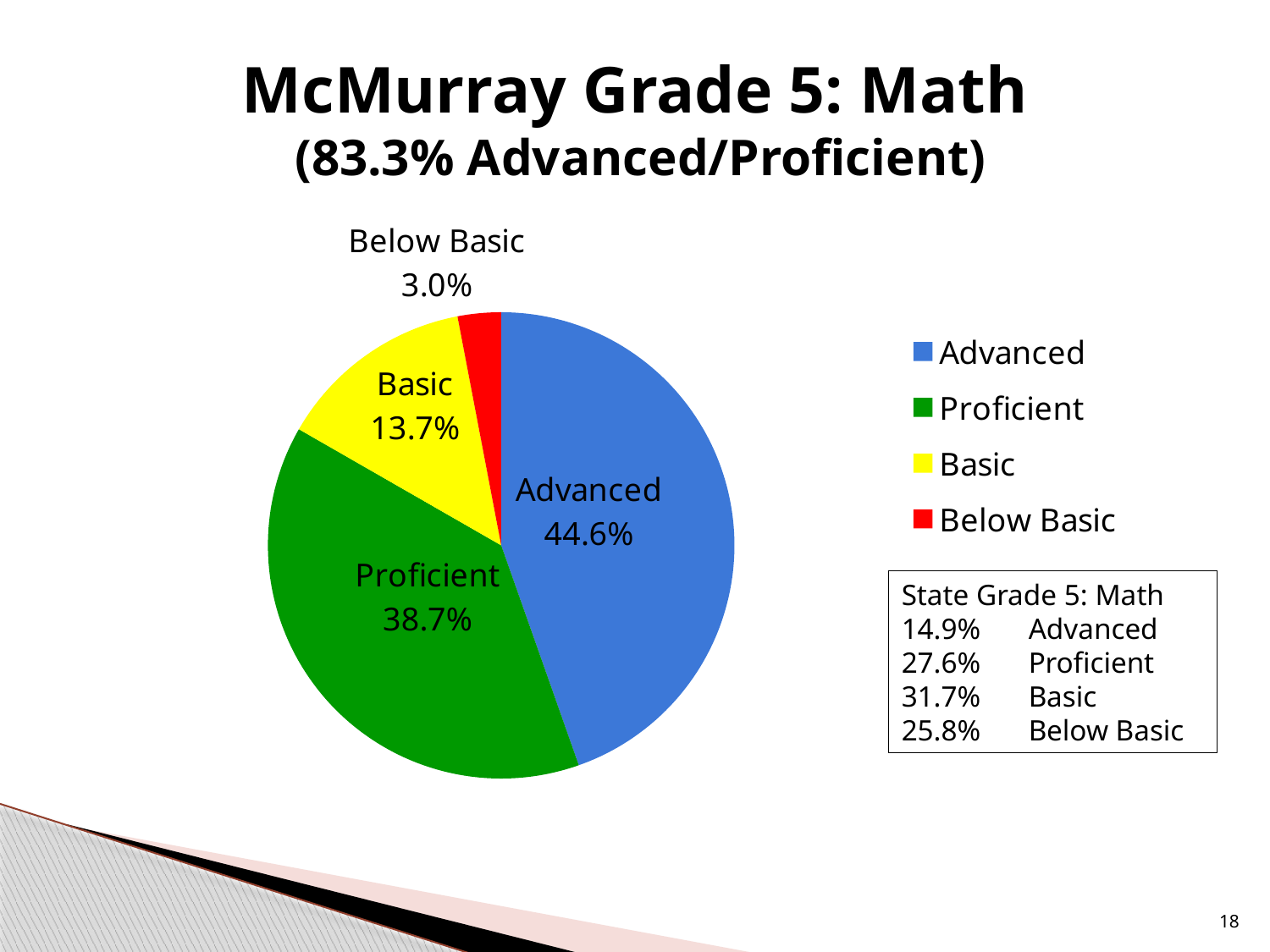
What is the difference in percentage points between the Advanced and Proficient slices? 5.9 What type of chart is shown on the slide? Pie chart Which performance level has the smallest share of the pie? Below Basic What colour is the Proficient slice in the pie chart? Green What percentage of McMurray Grade 5 students scored Basic in Math? 13.7% How many slices does the pie chart have? 4 Which slice is larger, Basic or Below Basic? Basic What percentage of McMurray Grade 5 students scored Below Basic in Math? 3.0% What percentage of McMurray Grade 5 students scored Proficient in Math? 38.7% What percentage of McMurray Grade 5 students scored Advanced in Math? 44.6% How many entries does the chart legend list? 4 Which performance level has the largest share of the pie? Advanced